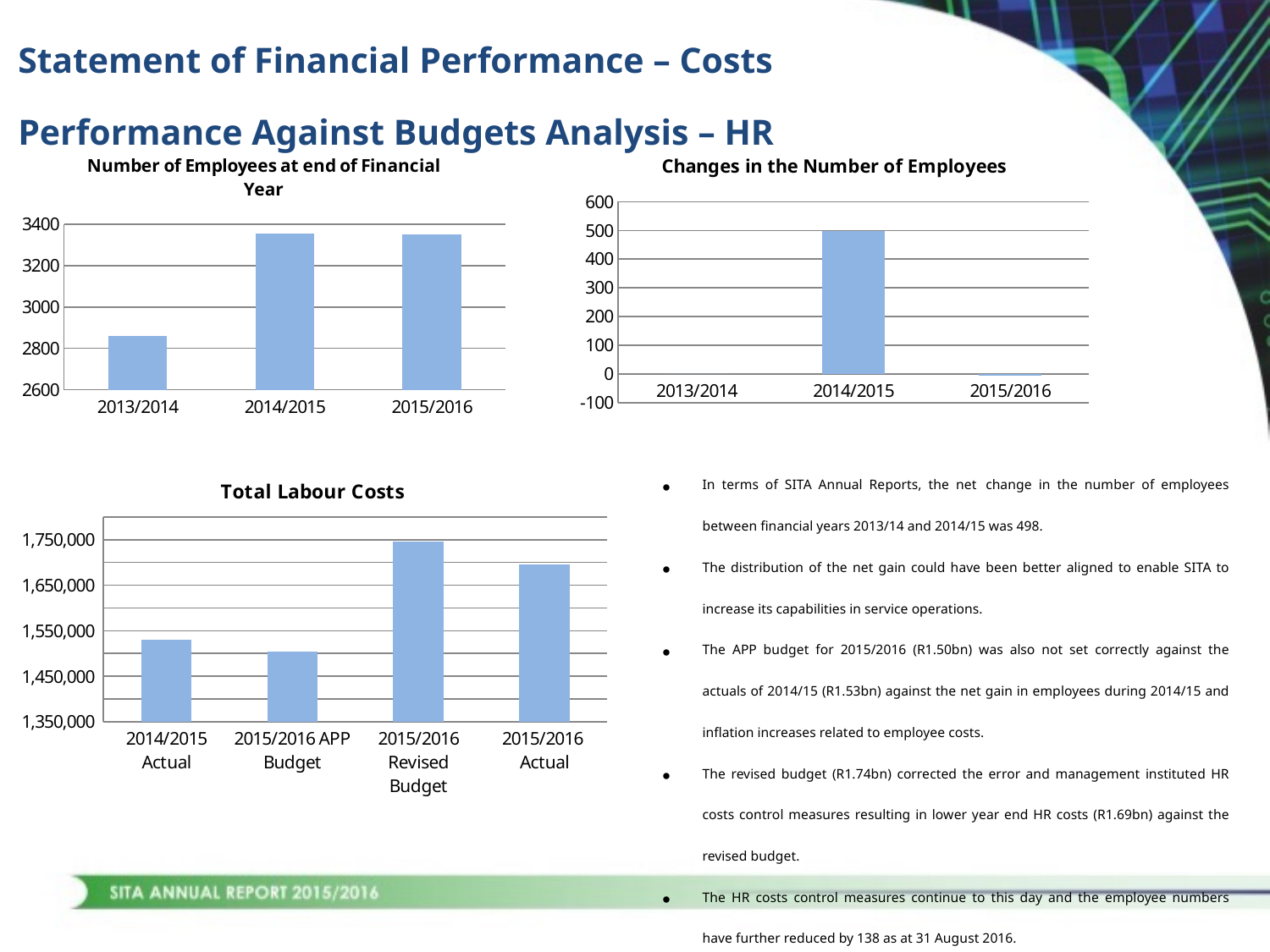
In the 'Number of Employees at end of Financial Year' chart, is the value for 2013/2014 greater or less than 3000? less In the 'Number of Employees at end of Financial Year' chart, is the value for 2014/2015 greater or less than 3200? greater In the 'Total Labour Costs' chart, which category has the highest value? 2015/2016 Revised Budget In the 'Number of Employees at end of Financial Year' chart, how many financial years are shown? 3 What kind of chart is the 'Changes in the Number of Employees' chart? Bar chart How many categories are shown in the 'Total Labour Costs' chart? 4 In the 'Total Labour Costs' chart, is the value for 2015/2016 APP Budget greater or less than 1,550,000? less In the 'Number of Employees at end of Financial Year' chart, which financial year has the lowest number of employees? 2013/2014 In the 'Changes in the Number of Employees' chart, which financial year has the highest change? 2014/2015 In the 'Total Labour Costs' chart, which is larger: 2015/2016 Revised Budget or 2015/2016 Actual? 2015/2016 Revised Budget